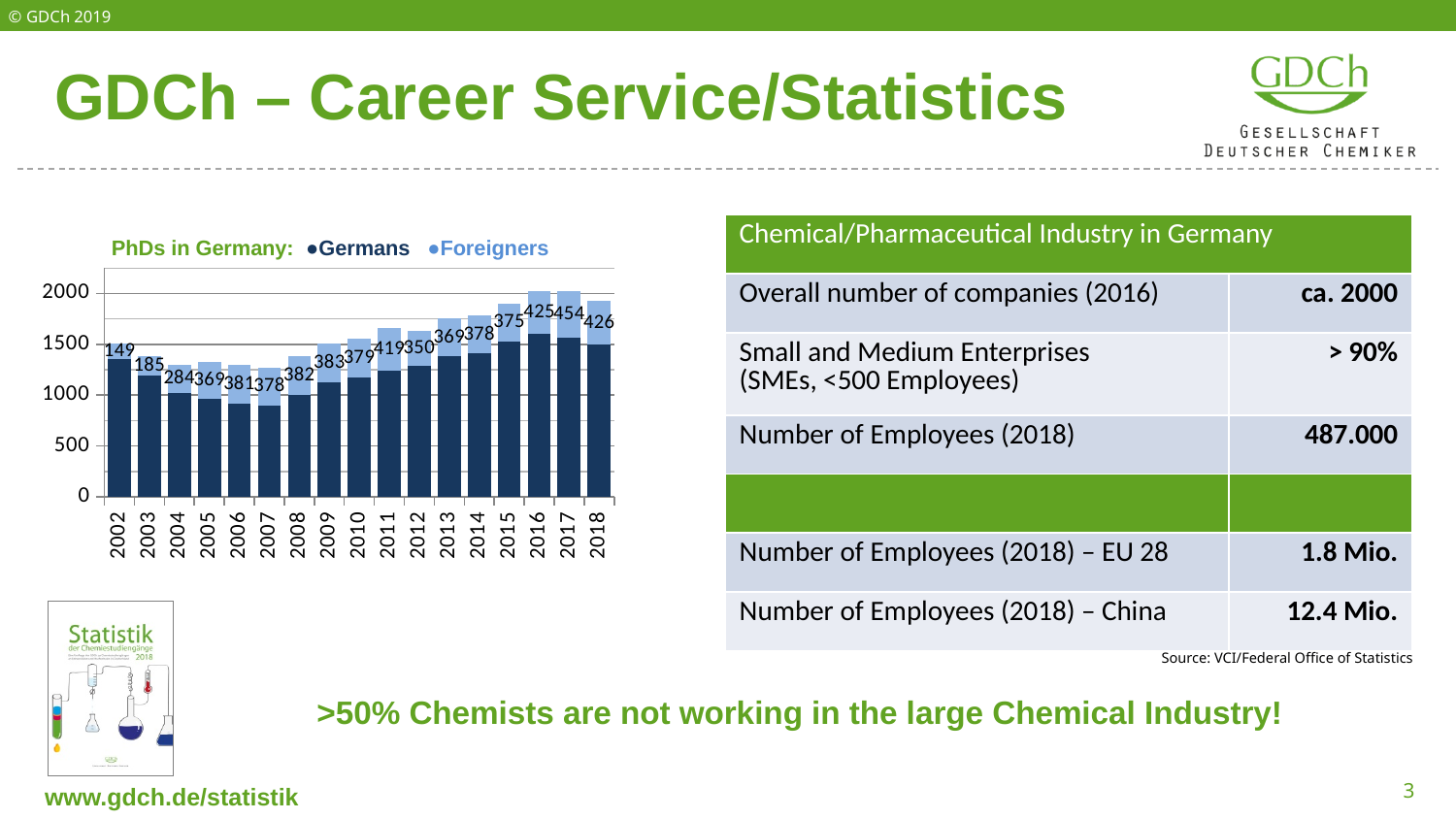
What type of chart is shown on the slide? bar chart What is the value for Foreigners in 2002 in the PhDs in Germany chart? 149 In which year is the Foreigners value lowest in the PhDs in Germany chart? 2002 What is the value for Foreigners in 2018 in the PhDs in Germany chart? 426 In which year is the Foreigners value highest in the PhDs in Germany chart? 2017 What is the difference between the Foreigners values for 2017 and 2016? 29 How many series does the legend of the PhDs in Germany chart list? 2 What is the value for Foreigners in 2011 in the PhDs in Germany chart? 419 Is the total stacked bar for 2017 greater or less than 1500? greater Do the Foreigners values rise or fall from 2002 to 2005? rise Which year has a larger Foreigners value, 2012 or 2013? 2013 How many years are shown on the x axis of the PhDs in Germany chart? 17